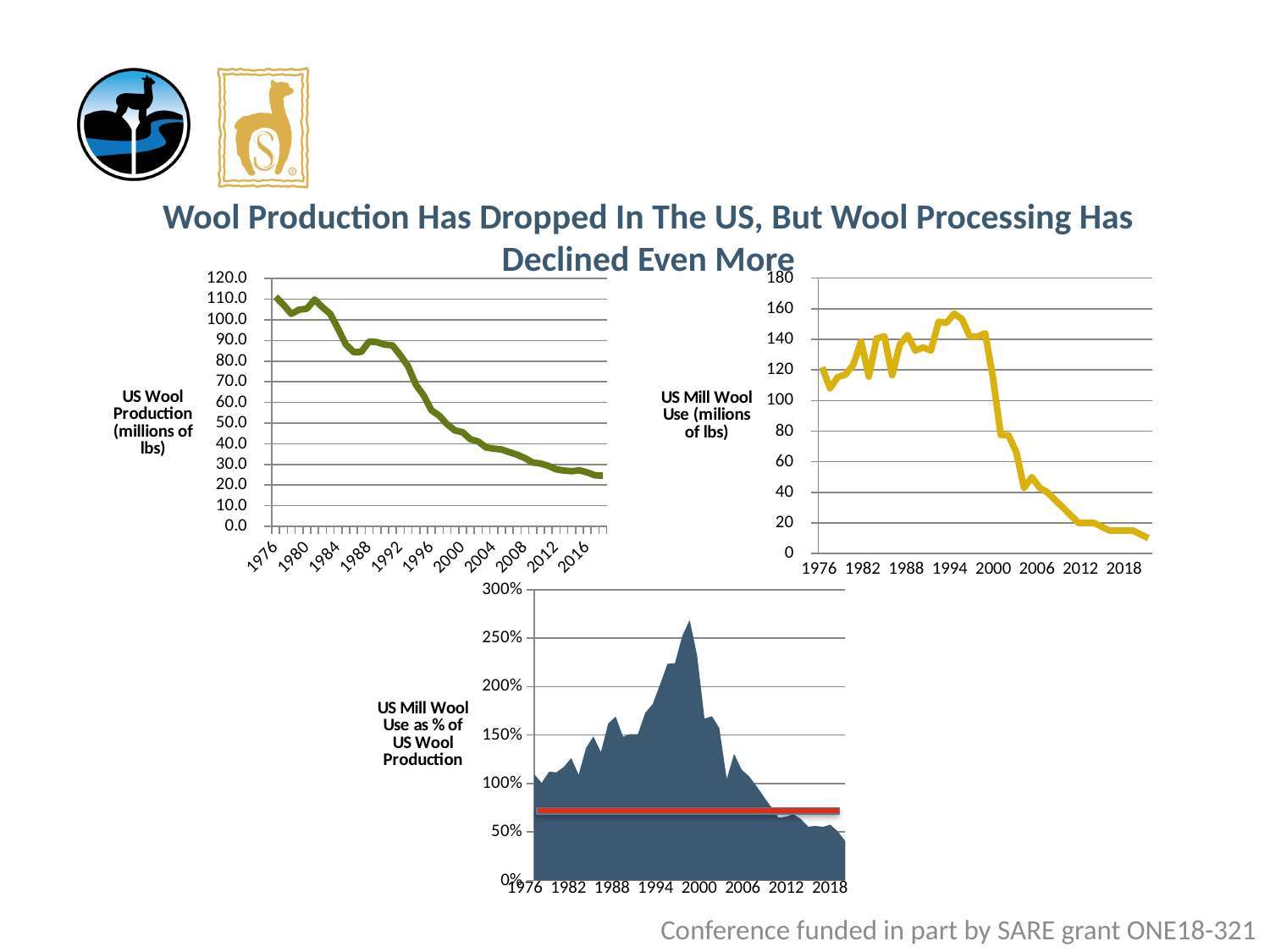
In the 'US Wool Production (millions of lbs)' chart, do the values rise or fall from 1976 to 2016? fall In the 'US Mill Wool Use (millions of lbs)' chart, which year has the higher value, 1976 or 2018? 1976 In the 'US Mill Wool Use (millions of lbs)' chart, is the value for 1994 greater or less than 140? greater How many charts are shown on the slide? 3 In the 'US Mill Wool Use as % of US Wool Production' chart, is the value for 2018 greater or less than 100%? less What kind of chart is the bottom chart titled 'US Mill Wool Use as % of US Wool Production'? area chart What kind of chart is the top-left chart titled 'US Wool Production (millions of lbs)'? line chart In the 'US Wool Production (millions of lbs)' chart, is the value for 2016 greater or less than 40.0? less In the 'US Mill Wool Use (millions of lbs)' chart, do the values rise or fall between 2000 and 2018? fall